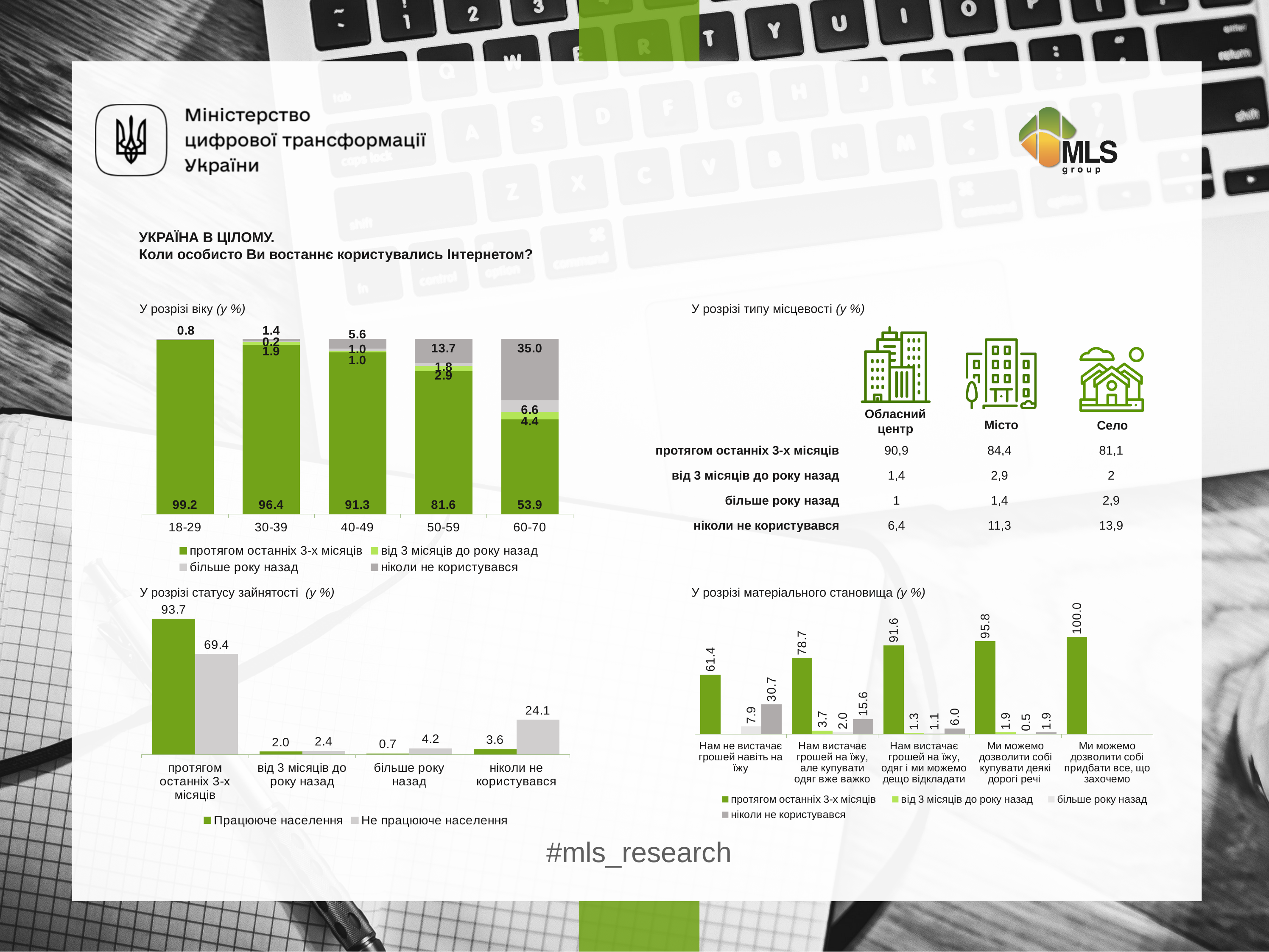
In the chart 'У розрізі матеріального становища (у %)' (bottom right), what is the value for 'протягом останніх 3-х місяців' in the category 'Нам не вистачає грошей навіть на їжу'? 61.4 In the chart 'У розрізі віку (у %)' (top left), does the value for 'протягом останніх 3-х місяців' rise or fall as age increases along the x axis? fall In the chart 'У розрізі матеріального становища (у %)' (bottom right), which category has the highest value for 'протягом останніх 3-х місяців'? Ми можемо дозволити собі придбати все, що захочемо In the chart 'У розрізі статусу зайнятості (у %)' (bottom left), what is the difference between 'Працююче населення' and 'Не працююче населення' for 'протягом останніх 3-х місяців'? 24.3 In the chart 'У розрізі матеріального становища (у %)' (bottom right), which is larger for 'ніколи не користувався': 'Нам не вистачає грошей навіть на їжу' or 'Нам вистачає грошей на їжу, але купувати одяг вже важко'? Нам не вистачає грошей навіть на їжу In the chart 'У розрізі статусу зайнятості (у %)' (bottom left), what is the value for 'Не працююче населення' in the category 'ніколи не користувався'? 24.1 In the chart 'У розрізі віку (у %)' (top left), which age group has the highest value for 'протягом останніх 3-х місяців'? 18-29 In the chart 'У розрізі віку (у %)' (top left), what is the value for 'протягом останніх 3-х місяців' in the 60-70 age group? 53.9 In the chart 'У розрізі віку (у %)' (top left), how many age groups are shown on the x axis? 5 In the chart 'У розрізі статусу зайнятості (у %)' (bottom left), what kind of chart is it? bar chart In the chart 'У розрізі віку (у %)' (top left), what is the value for 'ніколи не користувався' in the 50-59 age group? 13.7 In the chart 'У розрізі віку (у %)' (top left), how many series does the legend list? 4